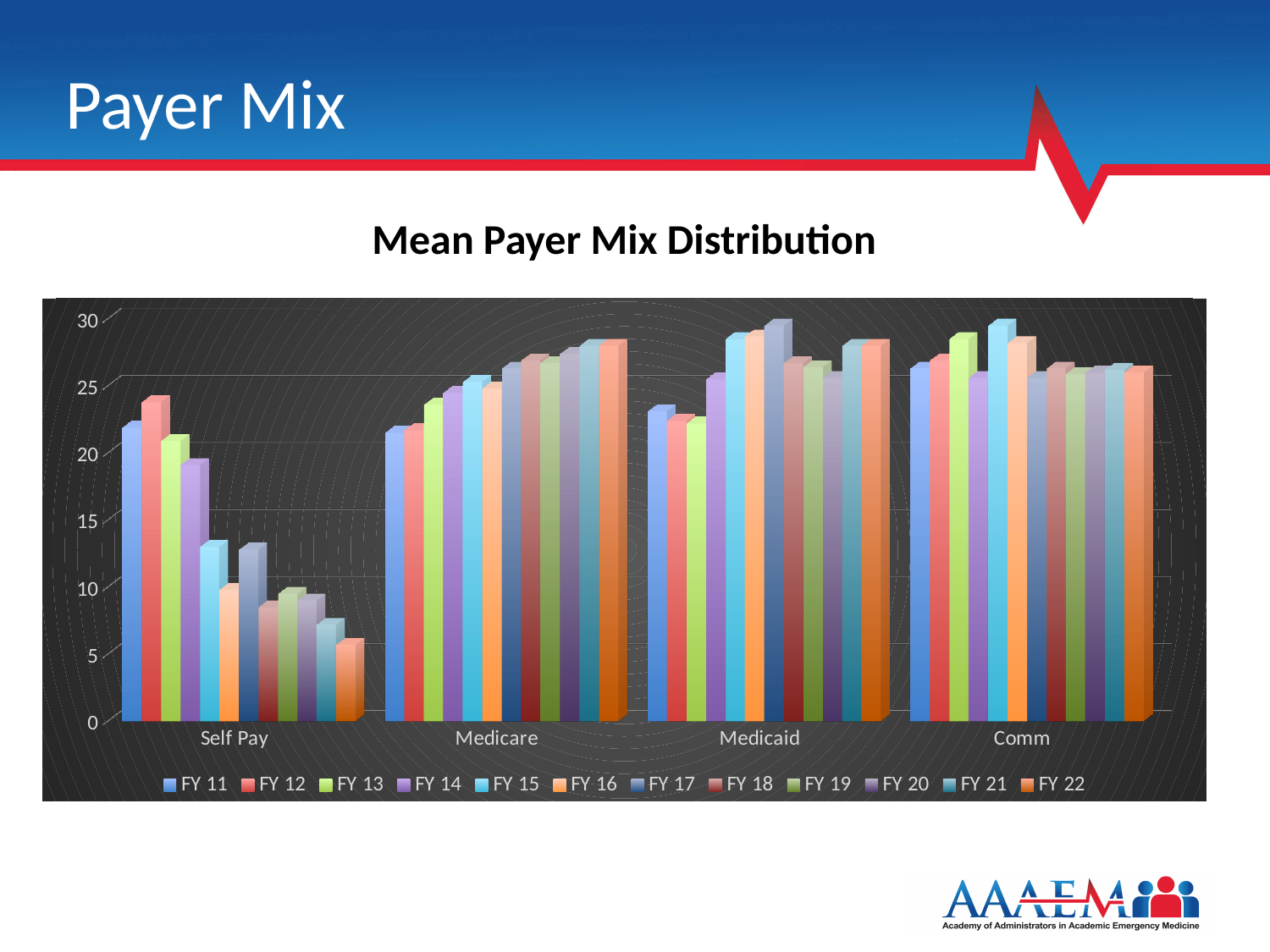
Is the value for Self Pay in FY 22 greater or less than 10? less What is the title of the chart? Mean Payer Mix Distribution What kind of chart is shown on the slide? Bar chart Which fiscal year has the highest value for Self Pay? FY 12 Is the value for Comm in FY 15 greater or less than 25? greater Which fiscal year has the lowest value for Self Pay? FY 22 Do the Self Pay values generally rise or fall from FY 11 to FY 22? Fall Which is larger, the FY 22 value for Self Pay or the FY 22 value for Comm? Comm Which fiscal year has the highest value for Medicaid? FY 17 Is the value for Medicare in FY 11 greater or less than 20? greater How many series does the legend list? 12 How many payer categories are shown on the x axis? 4